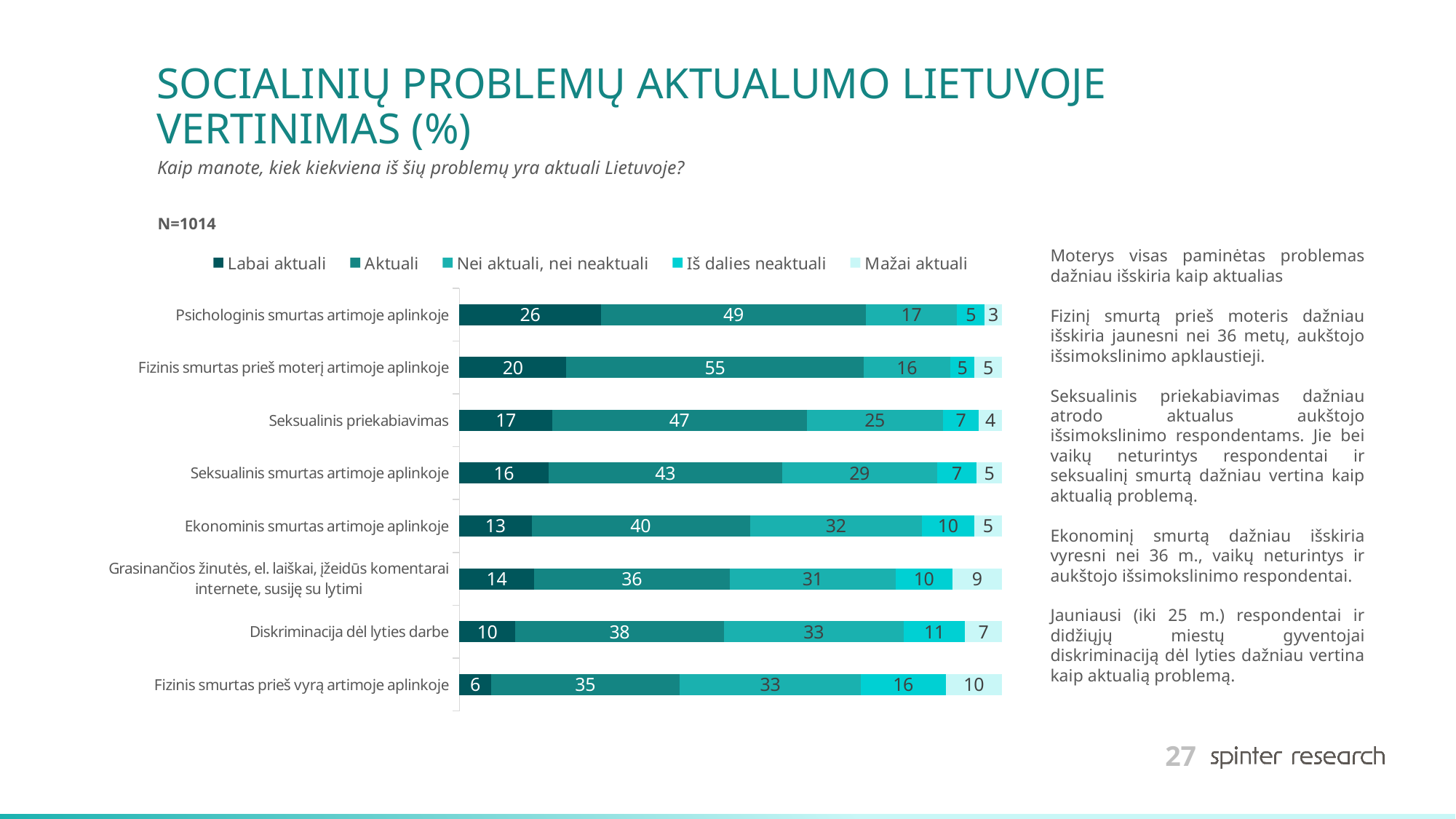
What type of chart is shown on the slide? Stacked bar chart Which category has the highest 'Labai aktuali' value? Psichologinis smurtas artimoje aplinkoje What is the 'Nei aktuali, nei neaktuali' value for 'Ekonominis smurtas artimoje aplinkoje'? 32 What is the 'Aktuali' value for 'Fizinis smurtas prieš moterį artimoje aplinkoje'? 55 How many categories (problems) are plotted in the chart? 8 Which is larger: the 'Mažai aktuali' value for 'Fizinis smurtas prieš vyrą artimoje aplinkoje' or for 'Seksualinis priekabiavimas'? Fizinis smurtas prieš vyrą artimoje aplinkoje How many series does the legend list? 5 What sample size (N) is stated on the slide? N=1014 What is the 'Labai aktuali' value for 'Psichologinis smurtas artimoje aplinkoje'? 26 Which category has the lowest 'Labai aktuali' value? Fizinis smurtas prieš vyrą artimoje aplinkoje What is the difference between the 'Aktuali' values for 'Fizinis smurtas prieš moterį artimoje aplinkoje' and 'Fizinis smurtas prieš vyrą artimoje aplinkoje'? 20 What is the total of the stacked bar for 'Seksualinis smurtas artimoje aplinkoje'? 100